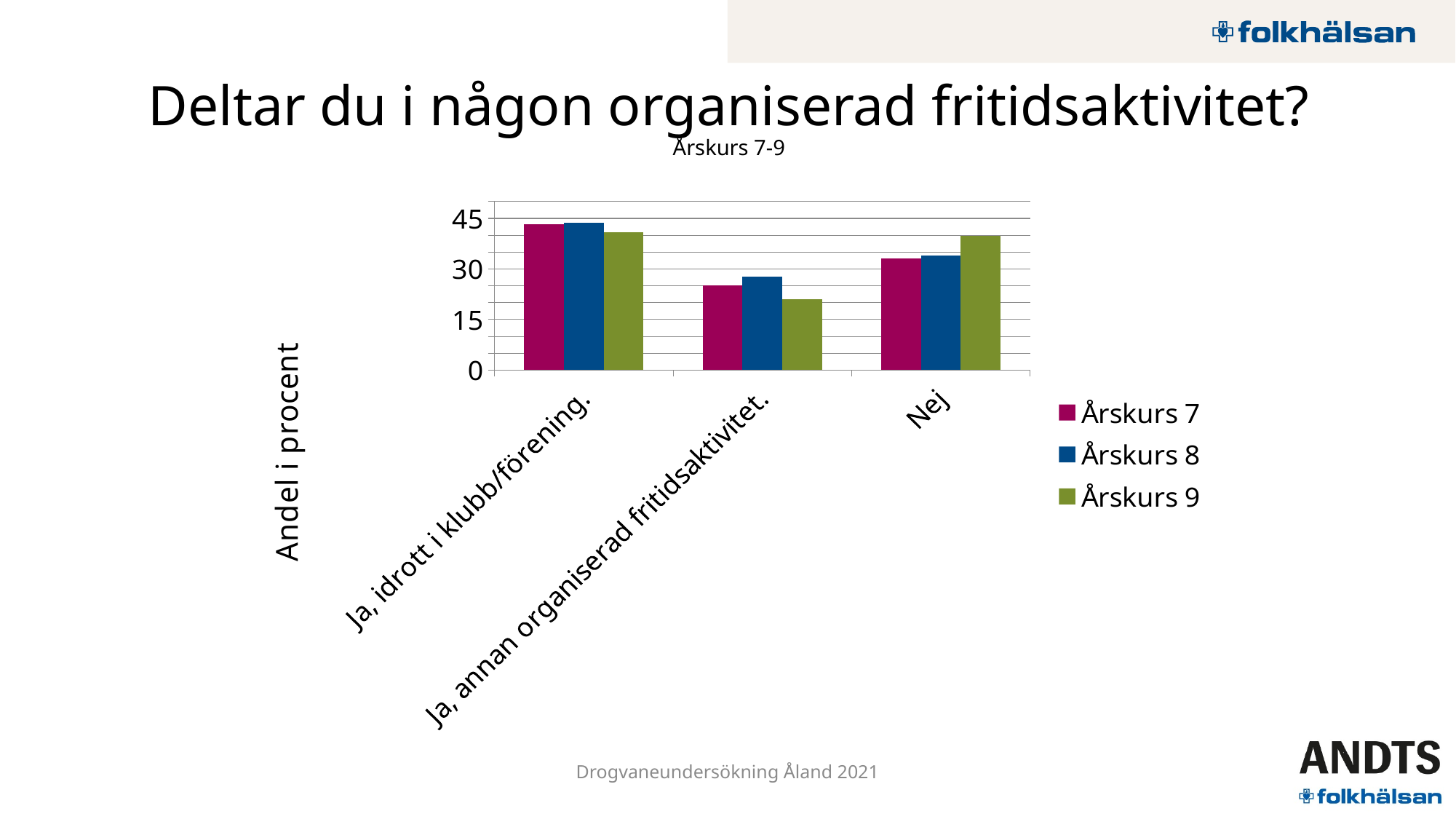
Is the value for Årskurs 9 in the category "Ja, annan organiserad fritidsaktivitet." greater or less than 30? less Is the value for Årskurs 7 in the category "Ja, idrott i klubb/förening." greater or less than 30? greater How many series does the legend list? 3 Is the value for Årskurs 9 in the category "Ja, annan organiserad fritidsaktivitet." greater or less than 15? greater What is the title of the vertical axis? Andel i procent Which series has the lowest value in the category "Ja, annan organiserad fritidsaktivitet."? Årskurs 9 What kind of chart is shown on the slide? bar chart How many categories are shown on the x axis? 3 Which series has the highest value in the category "Nej"? Årskurs 9 Which colour represents Årskurs 8 in the legend? blue For Årskurs 7, which is larger: the value for "Ja, idrott i klubb/förening." or the value for "Ja, annan organiserad fritidsaktivitet."? Ja, idrott i klubb/förening.